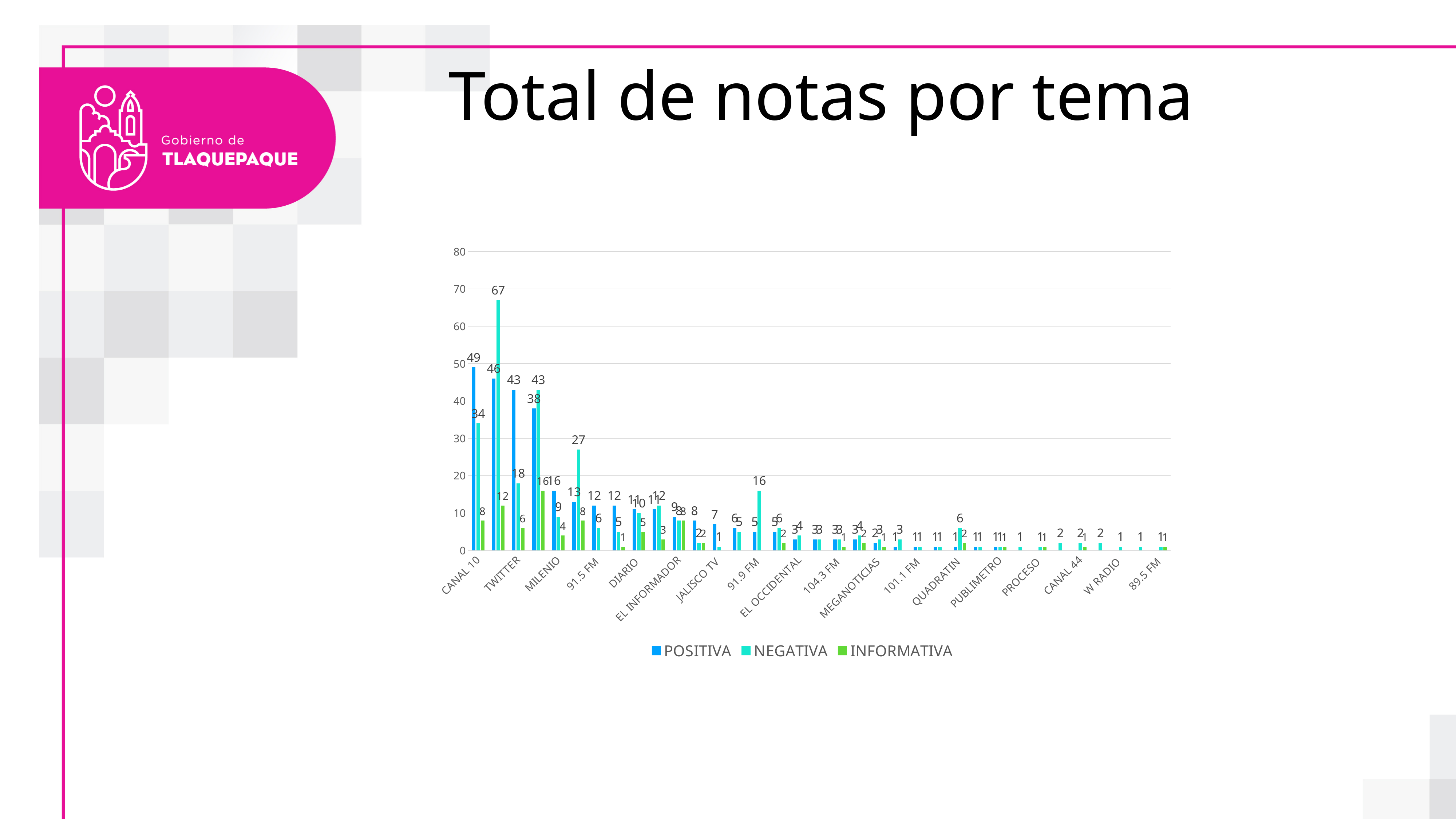
What is the NEGATIVA value for CANAL 10? 34 What is the INFORMATIVA value for CANAL 10? 8 What is the POSITIVA value for CANAL 10? 49 How many series does the legend list? 3 Which series is shown in green in the legend? INFORMATIVA What is the title of the slide? Total de notas por tema What is the highest value shown anywhere on the chart? 67 Is the tallest NEGATIVA bar greater or less than 60? greater Which series contains the tallest bar on the chart? NEGATIVA For CANAL 10, which is larger, the POSITIVA value or the NEGATIVA value? POSITIVA What is the difference between the POSITIVA and NEGATIVA values for CANAL 10? 15 What kind of chart is shown on the slide? bar chart